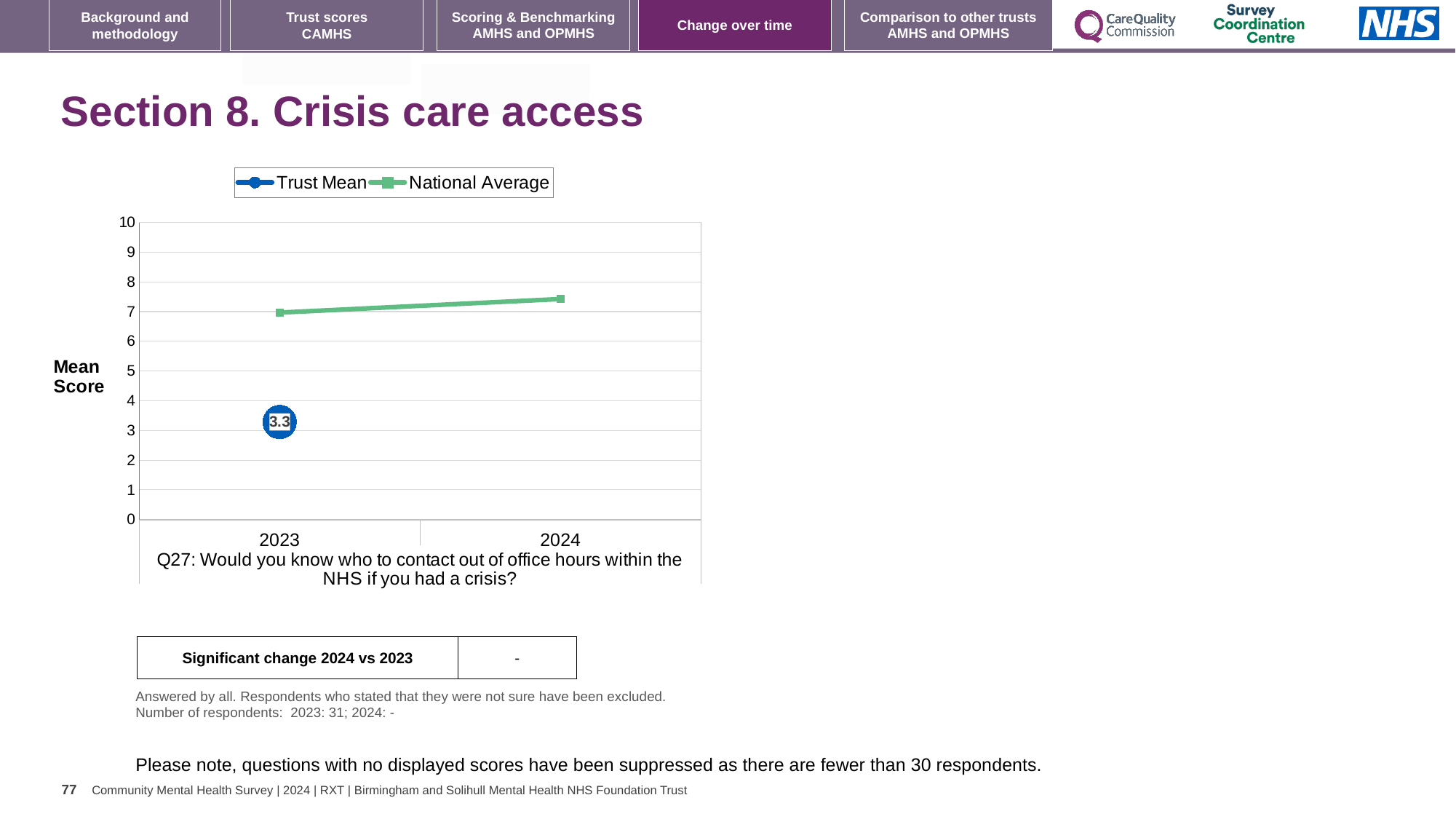
How many series does the legend list? 2 In 2023, which is larger: the Trust Mean or the National Average? National Average Does the National Average rise or fall from 2023 to 2024? rise Is the National Average for 2024 greater or less than 8? less Is the National Average for 2023 greater or less than 6? greater What is the label on the y axis? Mean Score Which series is shown in green? National Average What kind of chart is shown on the slide? line chart What is the Trust Mean value for 2023? 3.3 Is the Trust Mean for 2023 greater or less than 4? less How many years are shown on the x axis? 2